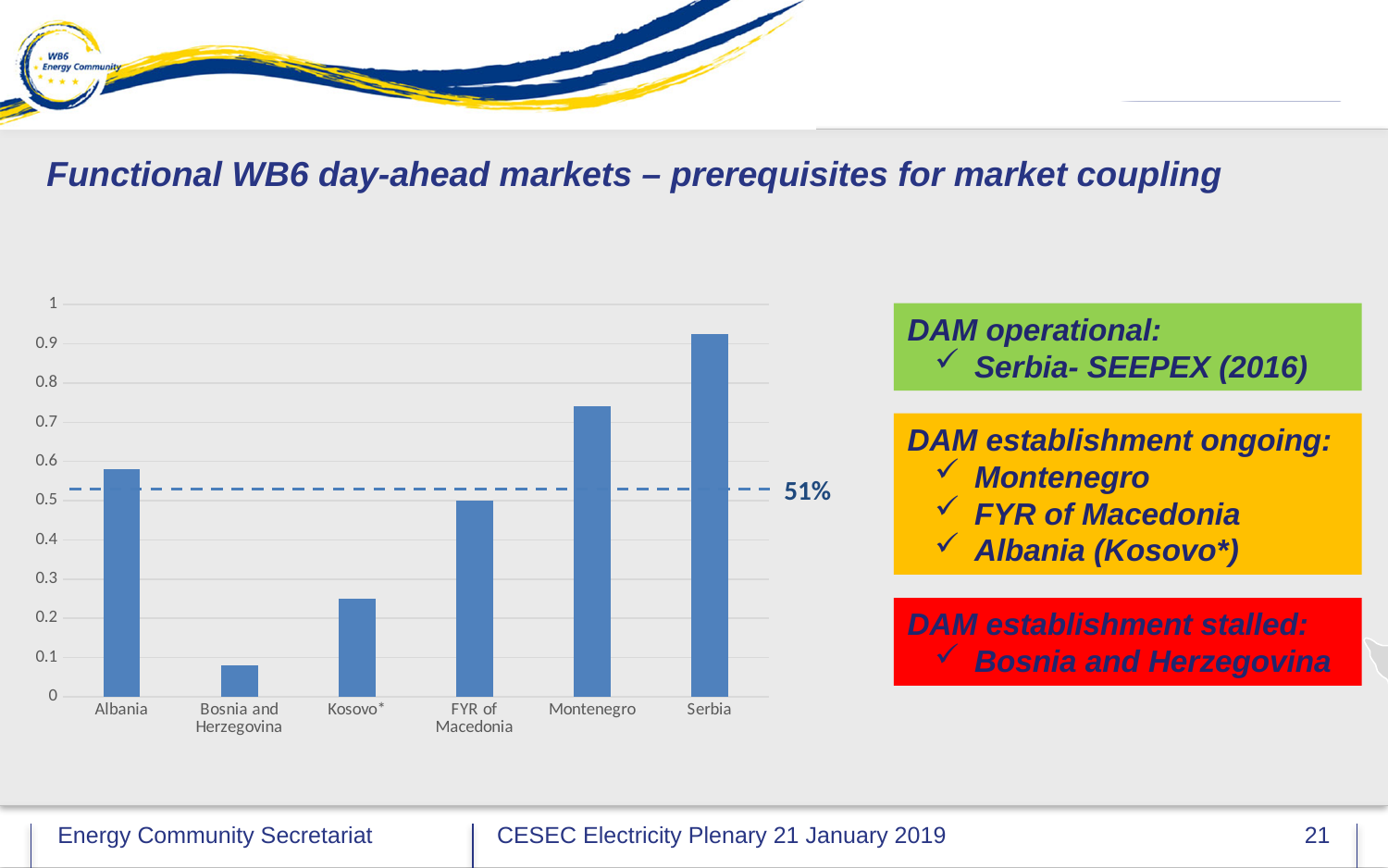
Is the value for Serbia greater or less than 0.8? greater Which country has the highest bar in the chart? Serbia How many countries are shown on the x axis of the chart? 6 Which has the higher value, Kosovo* or Albania? Albania Is the value for Montenegro greater or less than 0.6? greater Is the value for Kosovo* greater or less than 0.3? less Which has the higher value, Montenegro or Albania? Montenegro Which country has the lowest bar in the chart? Bosnia and Herzegovina What kind of chart is shown on the slide? bar chart What percentage is labelled on the horizontal dashed line in the chart? 51%